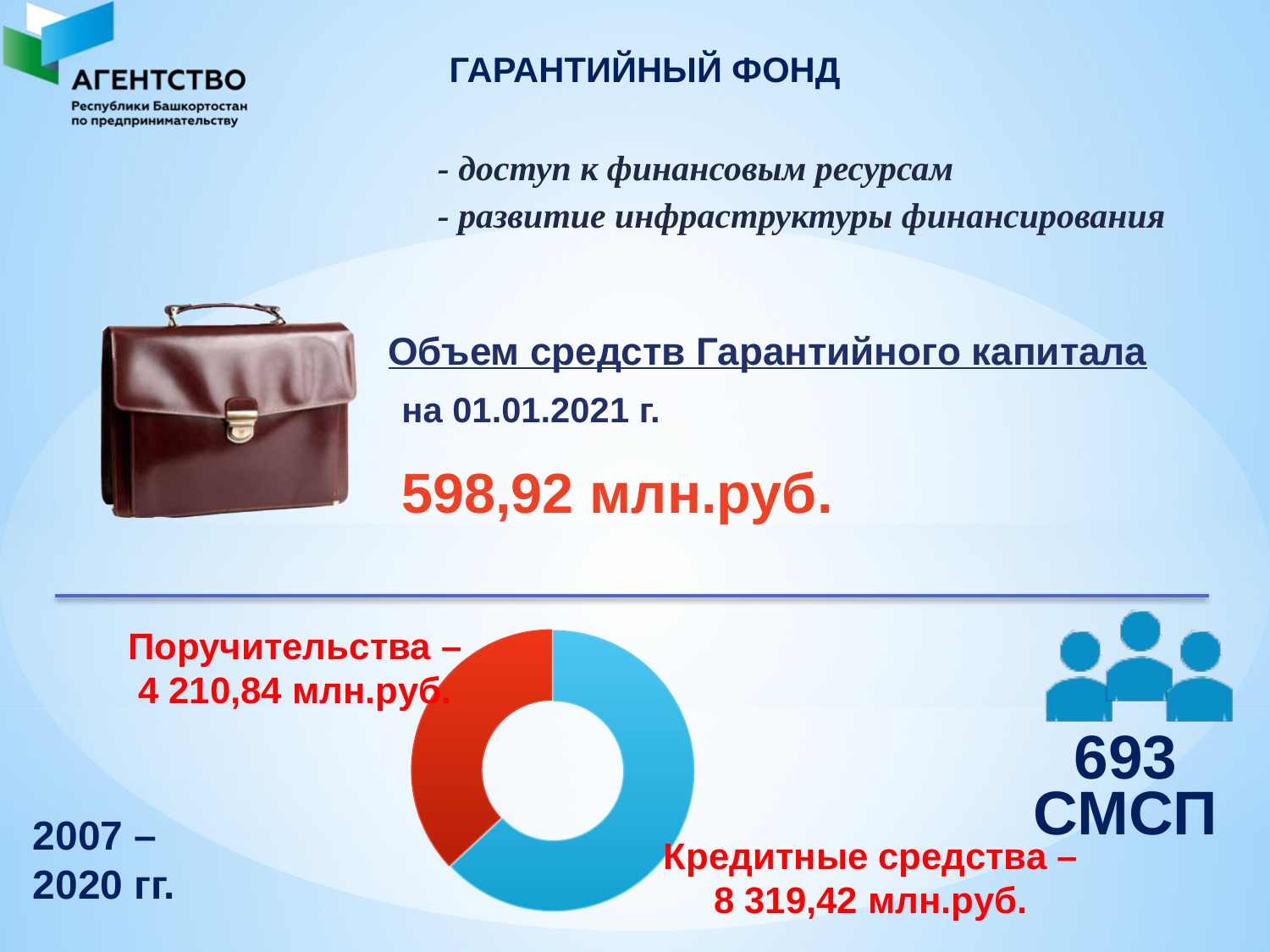
What period does the doughnut chart cover, according to the label next to it? 2007 – 2020 гг. What is the total of the two segments in the doughnut chart? 12 530,26 млн.руб. What is the value shown for Кредитные средства in the doughnut chart? 8 319,42 млн.руб. How many segments does the doughnut chart have? 2 Which segment of the doughnut chart is the largest? Кредитные средства What colour is the Поручительства segment in the doughnut chart? Red What kind of chart is shown at the bottom of the slide? Doughnut (pie) chart Which is larger in the doughnut chart: Поручительства or Кредитные средства? Кредитные средства What is the value shown for Поручительства in the doughnut chart? 4 210,84 млн.руб. Which segment of the doughnut chart is the smallest? Поручительства What is the difference between Кредитные средства and Поручительства in the doughnut chart? 4 108,58 млн.руб.